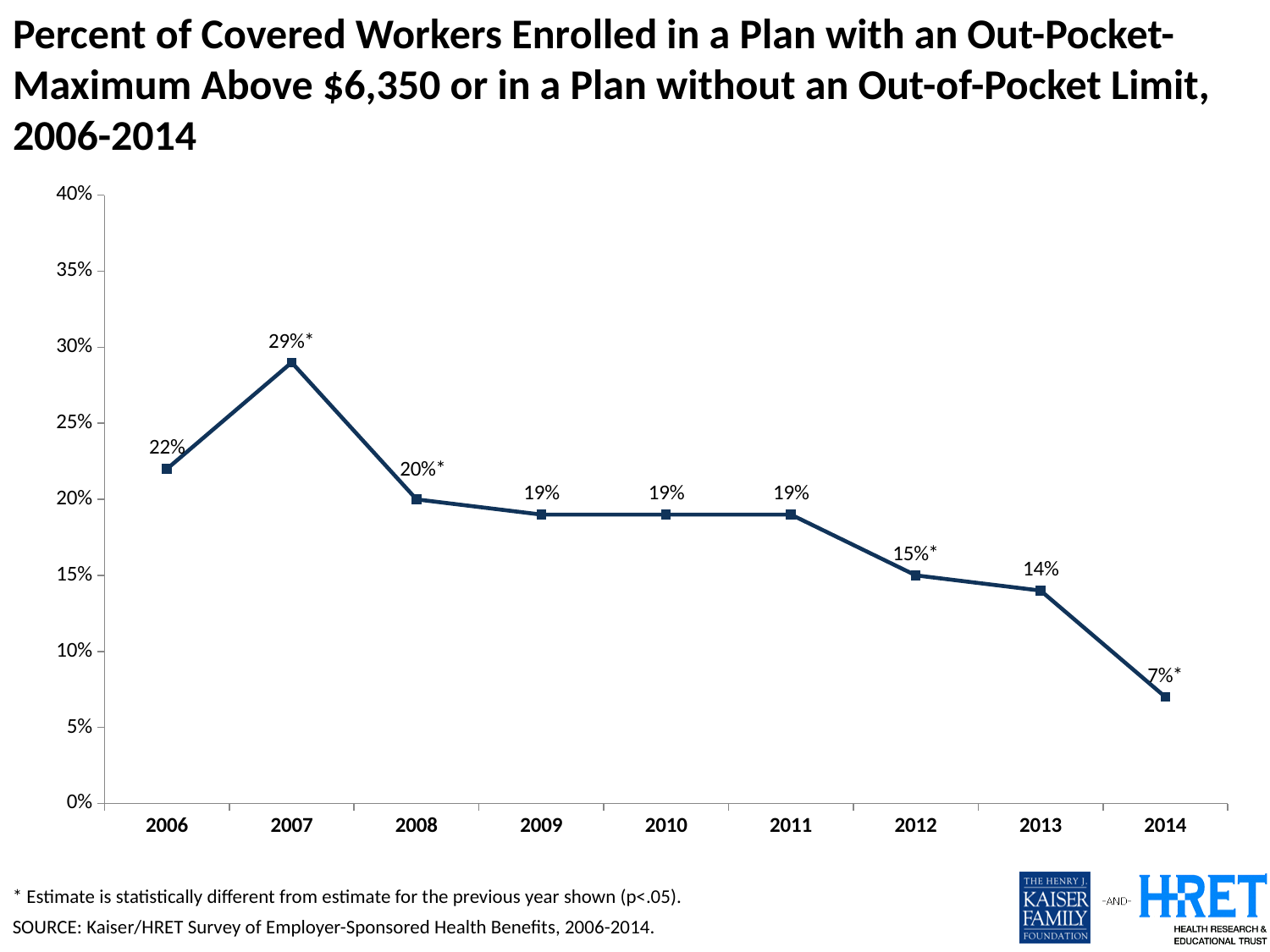
What kind of chart is shown on the slide? line chart What is the difference between the values for 2007 and 2008? 9% Which year has the lowest value? 2014 What is the value for 2014? 7% Is the value for 2007 greater or less than 25%? greater How many years are plotted on the chart? 9 What is the value for 2007? 29% Which is larger, the value for 2006 or the value for 2013? 2006 What is the value for 2012? 15% Which year has the highest value? 2007 Do the values rise or fall from 2008 to 2014? fall What is the difference between the values for 2006 and 2014? 15%